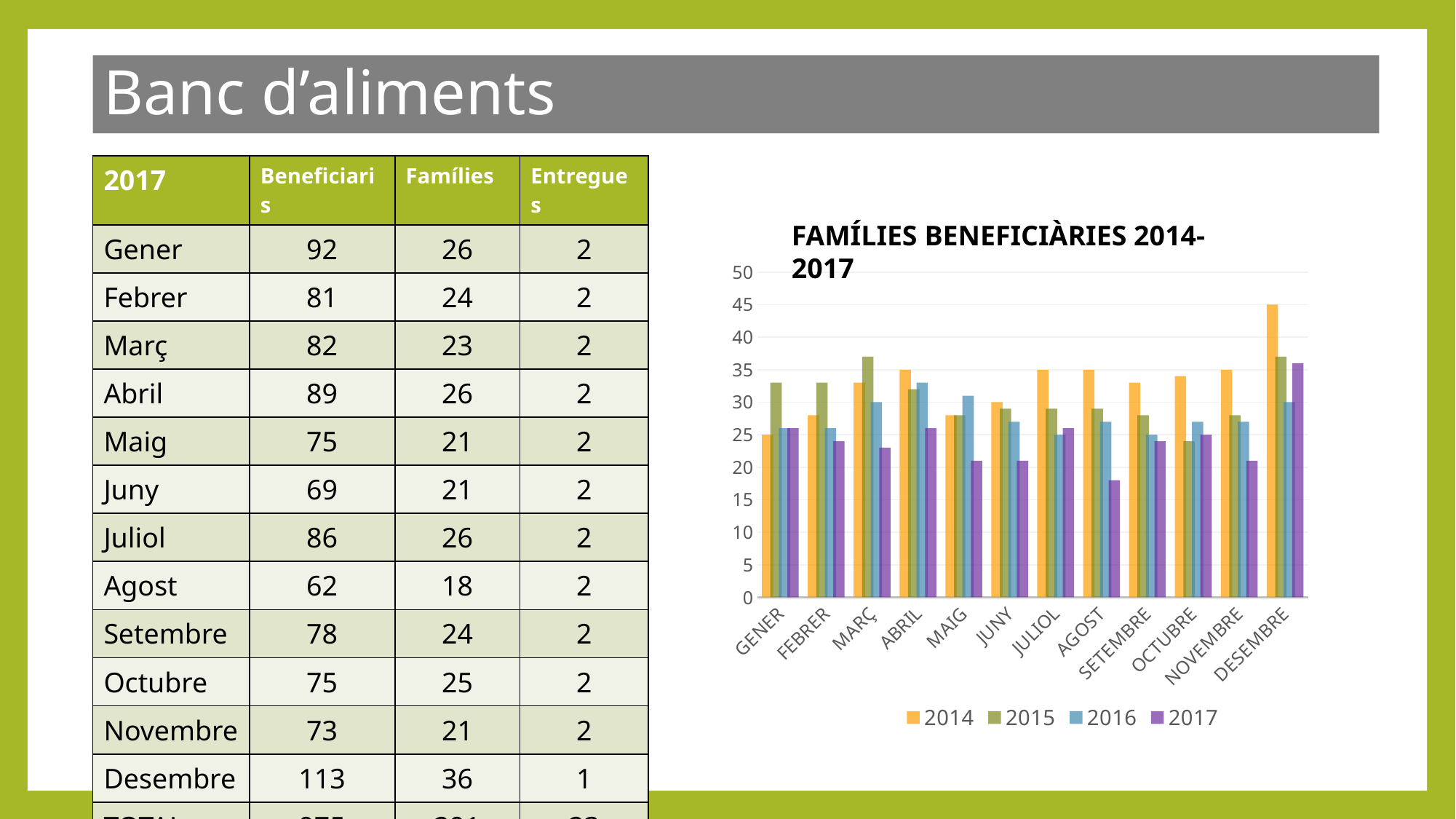
What is the title of the chart? FAMÍLIES BENEFICIÀRIES 2014-2017 In GENER, which series has the larger value, 2014 or 2015? 2015 Is the value for 2017 in AGOST greater or less than 20? less Which year does the orange series in the chart represent? 2014 What kind of chart is shown on the slide? bar chart In which month does the 2014 series reach its highest value? DESEMBRE How many months are shown on the x axis of the chart? 12 Is the value for 2014 in DESEMBRE greater or less than 40? greater How many series does the chart legend list? 4 Is the value for 2016 in GENER greater or less than 30? less In which month does the 2017 series have its lowest value? AGOST In which month does the 2014 series have its lowest value? GENER